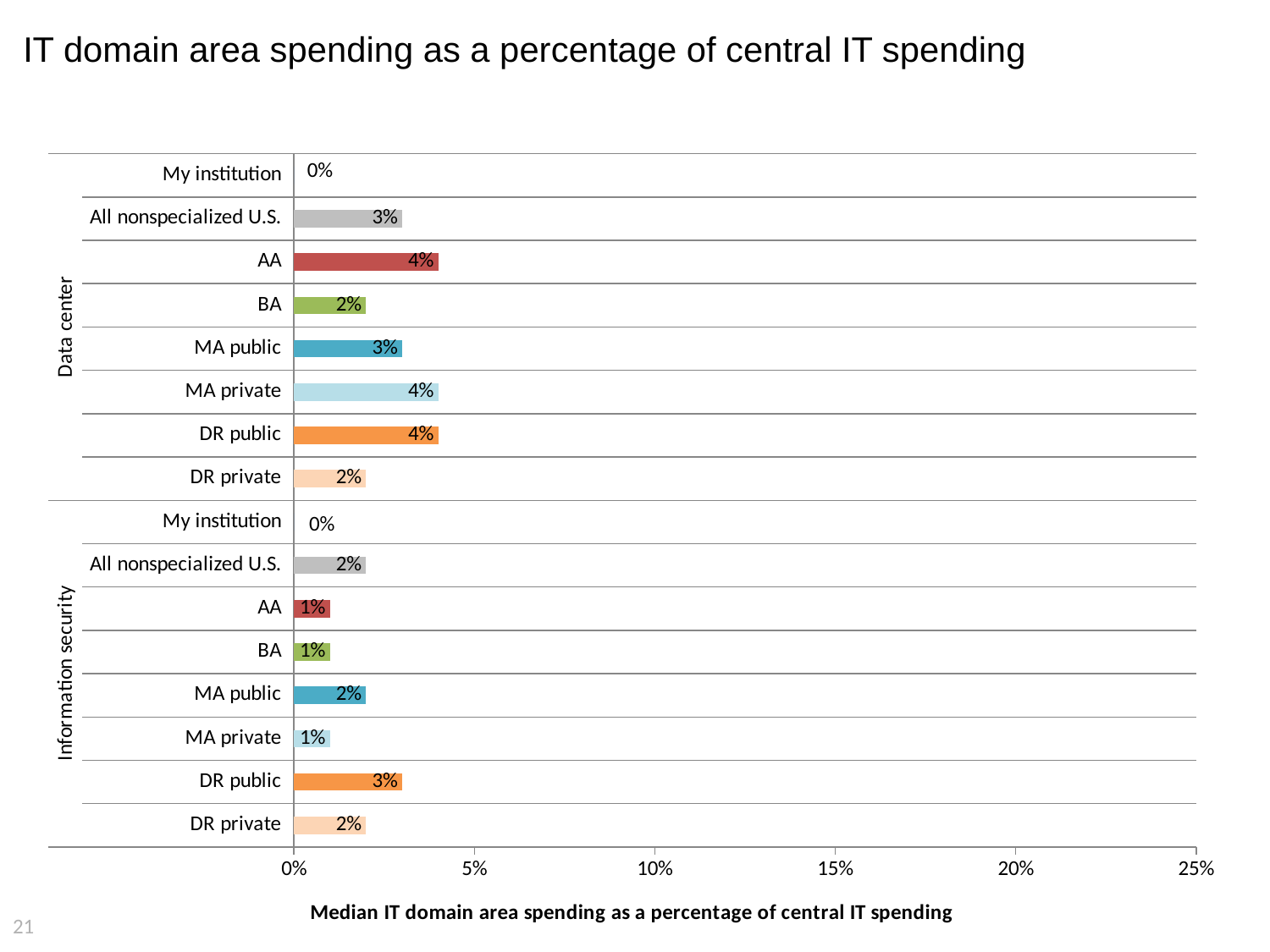
What is the Information security value for MA private? 1% What is the Information security value for DR public? 3% How many bars are plotted in the Information security group? 8 Within the Information security group, which category has the highest value? DR public Which is larger: the Data center value for MA public or the Information security value for MA public? Data center What is the difference between the Data center value for DR public and the Data center value for DR private? 2% What is the Data center value for AA? 4% What is the title of the horizontal axis? Median IT domain area spending as a percentage of central IT spending What kind of chart is shown on the slide? Bar chart What is the Data center value for All nonspecialized U.S.? 3% Within the Data center group, which category has the lowest value? My institution What is the maximum value shown on the horizontal axis? 25%